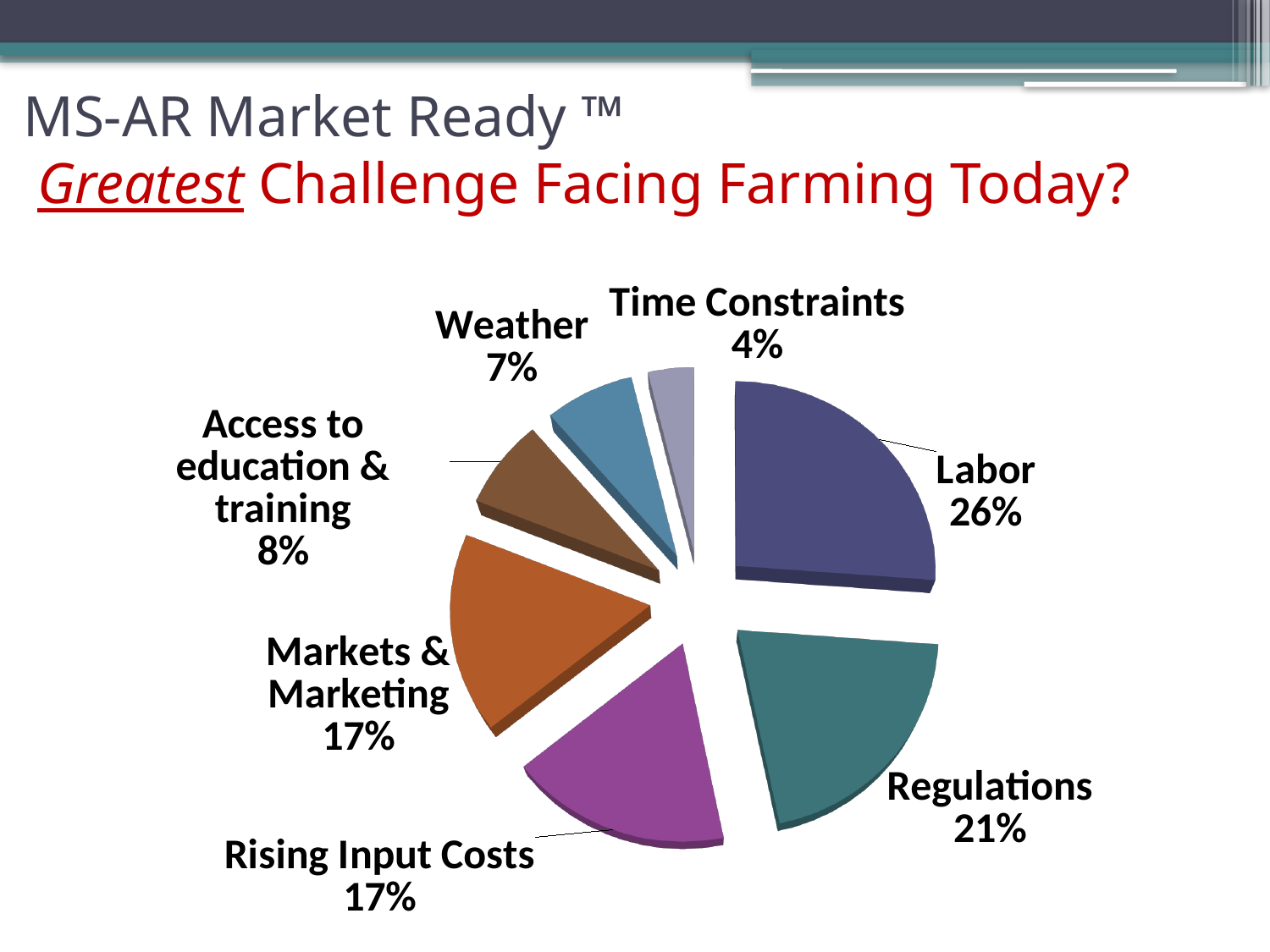
What percentage is shown for Access to education & training? 8% Which category has the largest slice of the pie? Labor What is the difference in percentage points between Labor and Regulations? 5 What is the combined percentage of Markets & Marketing and Rising Input Costs? 34% What percentage is shown for Regulations? 21% How many categories are shown in the pie chart? 7 What share of the pie does Labor account for? 26% What kind of chart is shown on the slide? Pie chart Which is larger, the share for Weather or the share for Access to education & training? Access to education & training What percentage is shown for Time Constraints? 4% What colour is the Regulations slice? Teal Which category has the smallest slice of the pie? Time Constraints